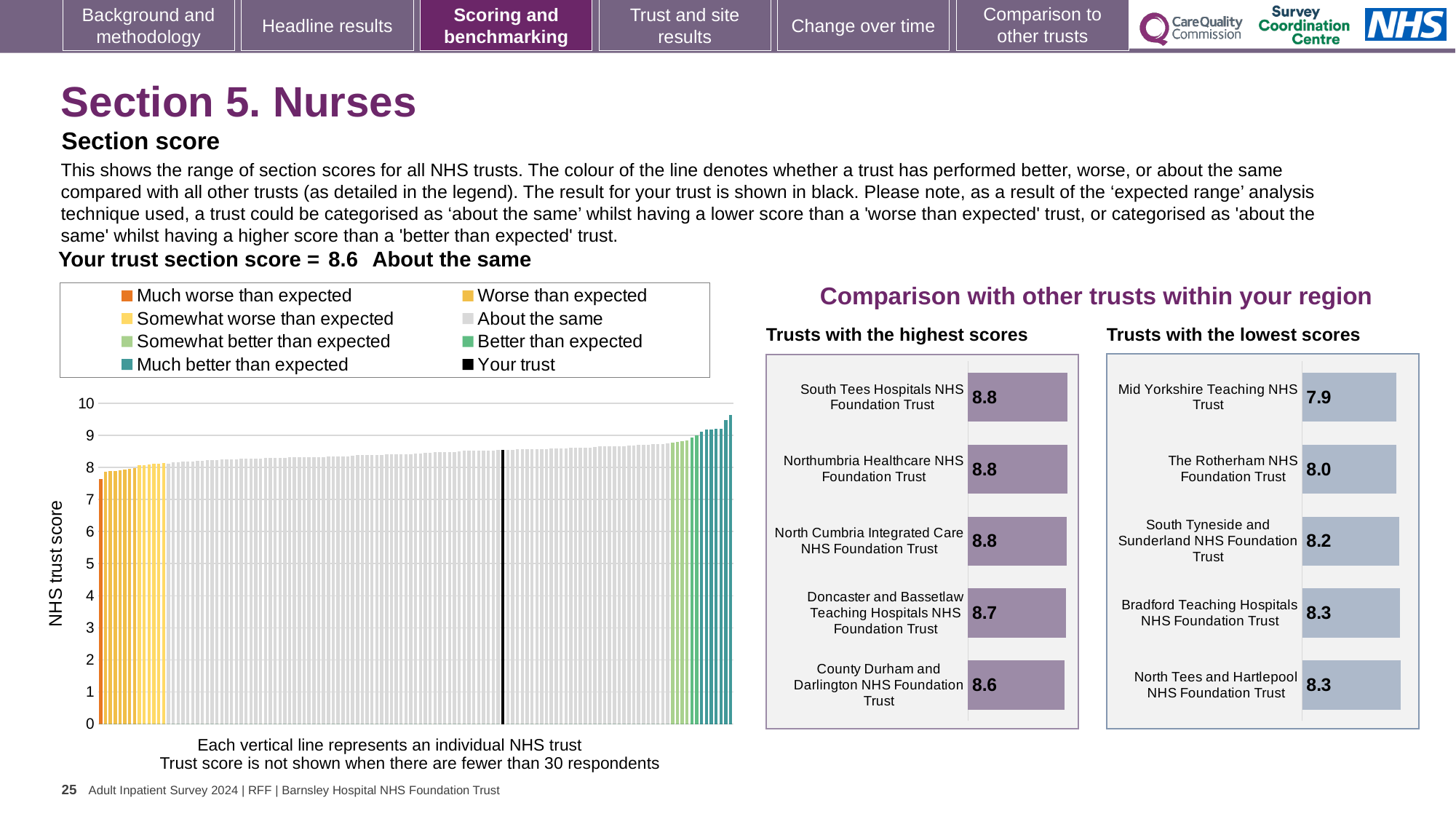
How many trusts are listed in the 'Trusts with the lowest scores' chart? 5 In the 'Trusts with the highest scores' chart, which trust has the lowest score? County Durham and Darlington NHS Foundation Trust How many entries does the legend of the main NHS trust score chart on the left list? 8 In the 'Trusts with the highest scores' chart, what is the score for Doncaster and Bassetlaw Teaching Hospitals NHS Foundation Trust? 8.7 In the 'Trusts with the lowest scores' chart, which trust has the lowest score? Mid Yorkshire Teaching NHS Trust What kind of chart is the main NHS trust score chart on the left? Bar chart In the 'Trusts with the lowest scores' chart, what is the score for Mid Yorkshire Teaching NHS Trust? 7.9 In the 'Trusts with the highest scores' chart, what is the difference between the scores of South Tees Hospitals NHS Foundation Trust and County Durham and Darlington NHS Foundation Trust? 0.2 In the 'Trusts with the lowest scores' chart, which has the higher score: The Rotherham NHS Foundation Trust or South Tyneside and Sunderland NHS Foundation Trust? South Tyneside and Sunderland NHS Foundation Trust In the main NHS trust score chart on the left, do the values rise or fall from left to right? Rise In the 'Trusts with the lowest scores' chart, what is the score for South Tyneside and Sunderland NHS Foundation Trust? 8.2 In the main NHS trust score chart on the left, is the value for 'Your trust' greater or less than 8? greater